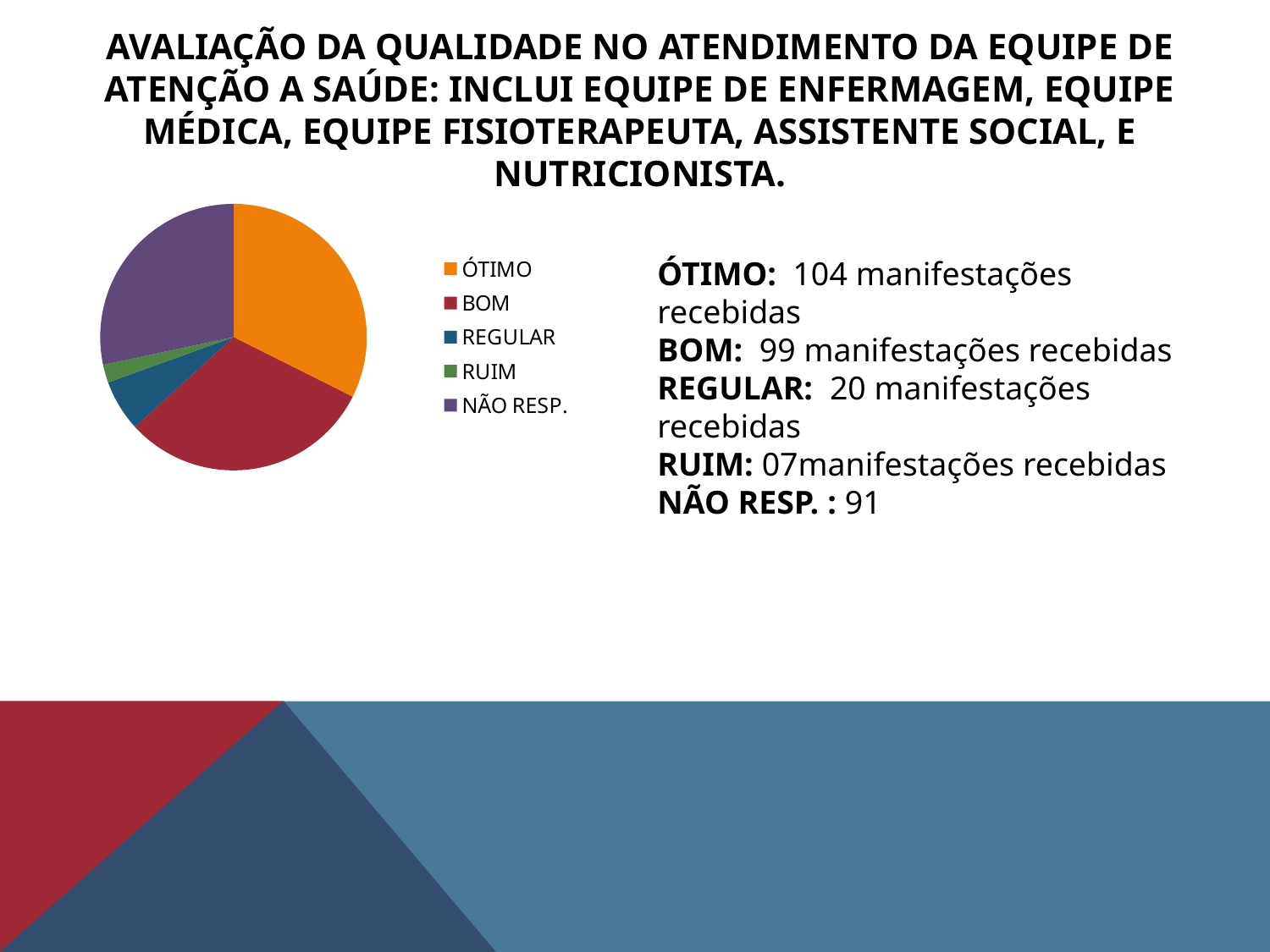
How many manifestações recebidas are reported for REGULAR? 20 What is the difference between the values for REGULAR and RUIM? 13 Which category has the smallest slice of the pie chart? RUIM How many categories does the pie chart have? 5 How many manifestações recebidas are reported for ÓTIMO? 104 What colour is the ÓTIMO slice in the pie chart? orange Which is larger, the value for ÓTIMO or the value for NÃO RESP.? ÓTIMO What value is given for NÃO RESP.? 91 How many entries does the legend of the pie chart list? 5 How many manifestações recebidas are reported for BOM? 99 Which category has the largest slice of the pie chart? ÓTIMO What kind of chart is shown on the slide? pie chart